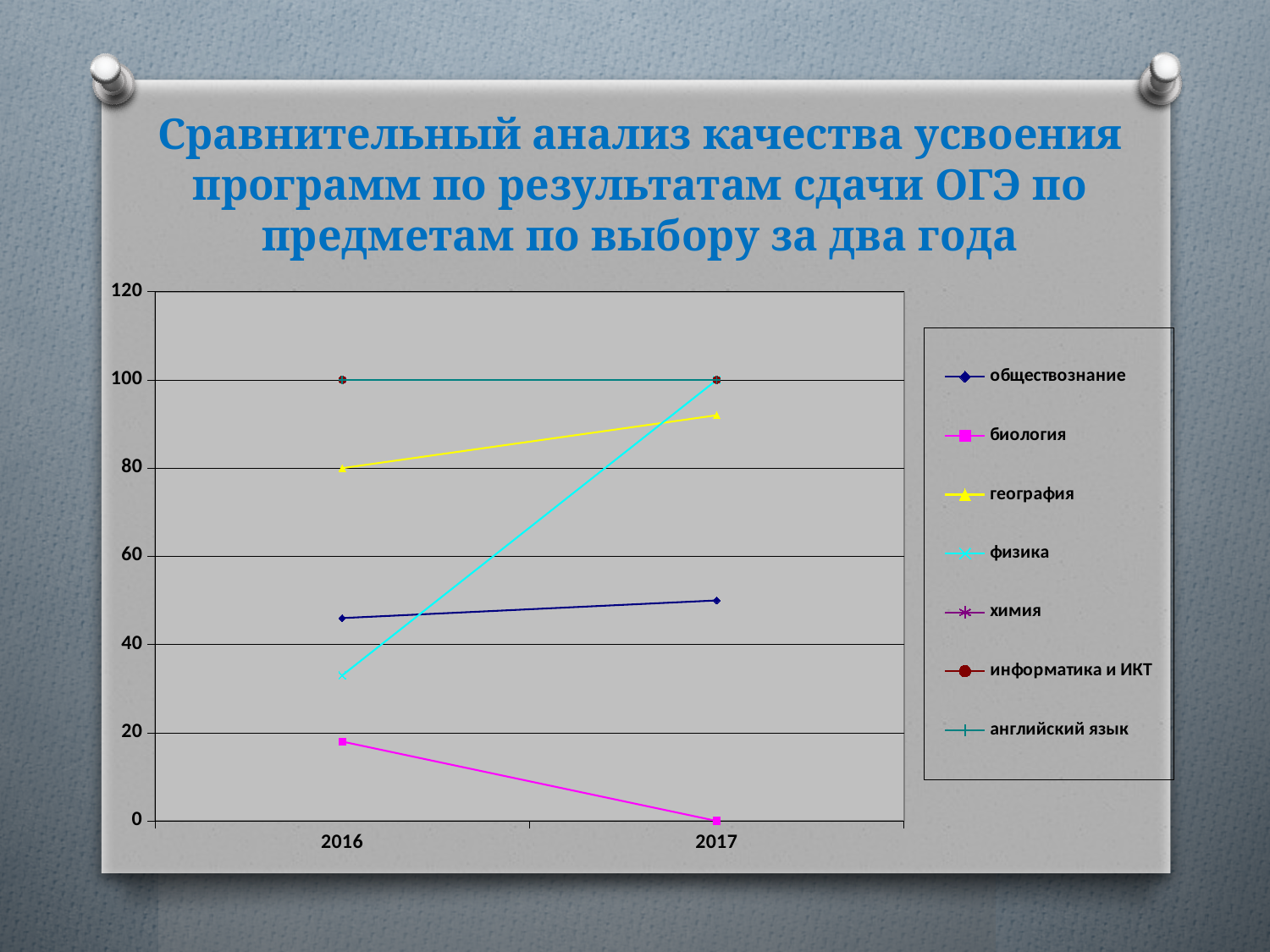
What is the value for география in 2016? 80 What is the value for физика in 2017? 100 Does the value for физика rise or fall from 2016 to 2017? rise Is the value for физика in 2016 greater or less than 40? less What is the value for английский язык in 2017? 100 Does the value for биология rise or fall from 2016 to 2017? fall Which is larger in 2016, the value for обществознание or the value for биология? обществознание What is the value for биология in 2017? 0 Which series has the lowest value in 2017? биология What kind of chart is shown on the slide? line chart How many years are shown on the x axis? 2 How many series does the legend list? 7